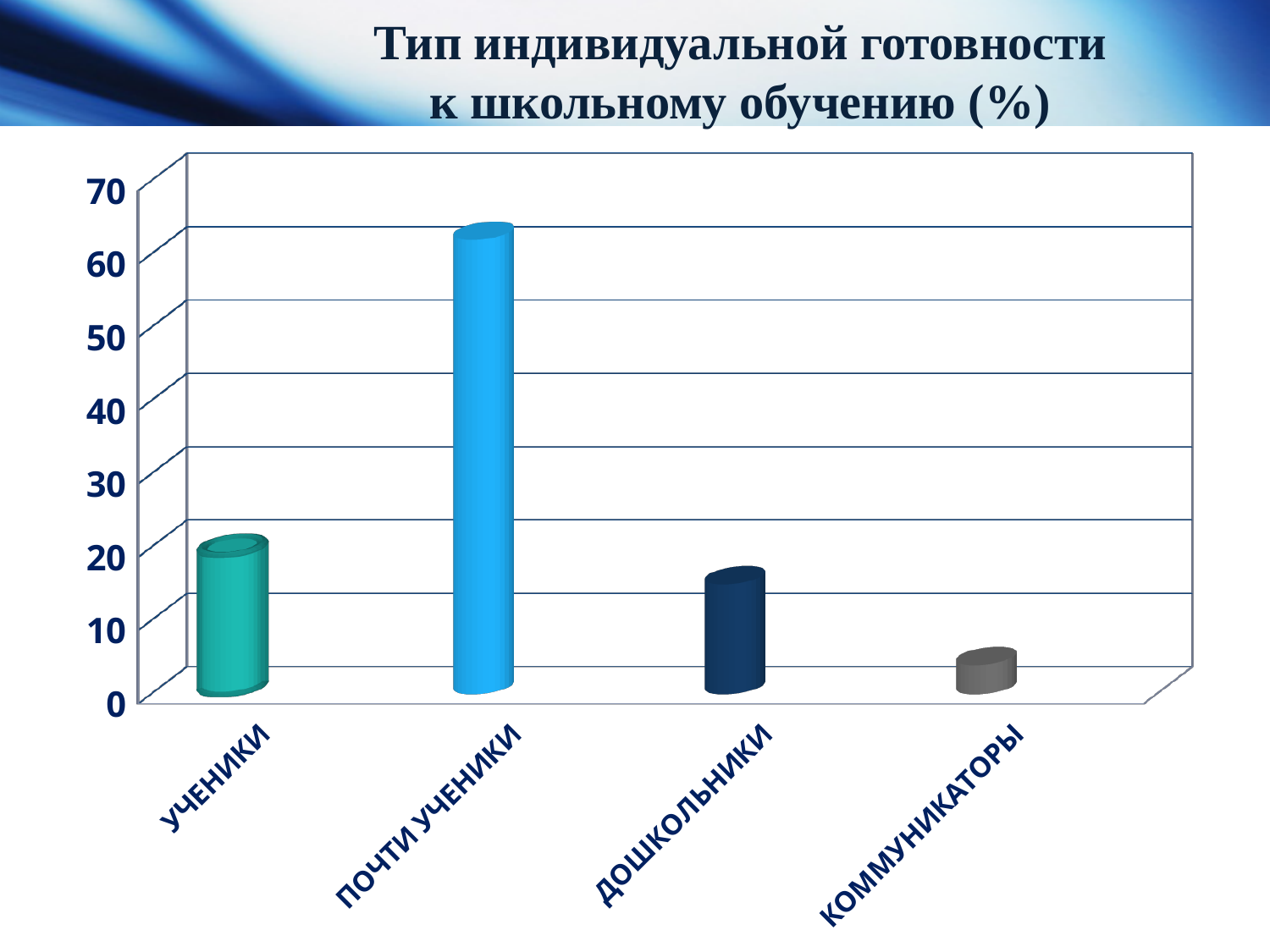
Which category has the highest value in the chart? ПОЧТИ УЧЕНИКИ Is the value for ПОЧТИ УЧЕНИКИ greater or less than 70? less Which is larger, the value for УЧЕНИКИ or the value for ДОШКОЛЬНИКИ? УЧЕНИКИ Is the value for КОММУНИКАТОРЫ greater or less than 10? less What is the title of the chart on the slide? Тип индивидуальной готовности к школьному обучению (%) Which is larger, the value for ПОЧТИ УЧЕНИКИ or the value for УЧЕНИКИ? ПОЧТИ УЧЕНИКИ Is the value for ДОШКОЛЬНИКИ greater or less than 20? less How many categories are shown on the x axis of the chart? 4 Which category has the lowest value in the chart? КОММУНИКАТОРЫ What kind of chart is shown on the slide? bar chart